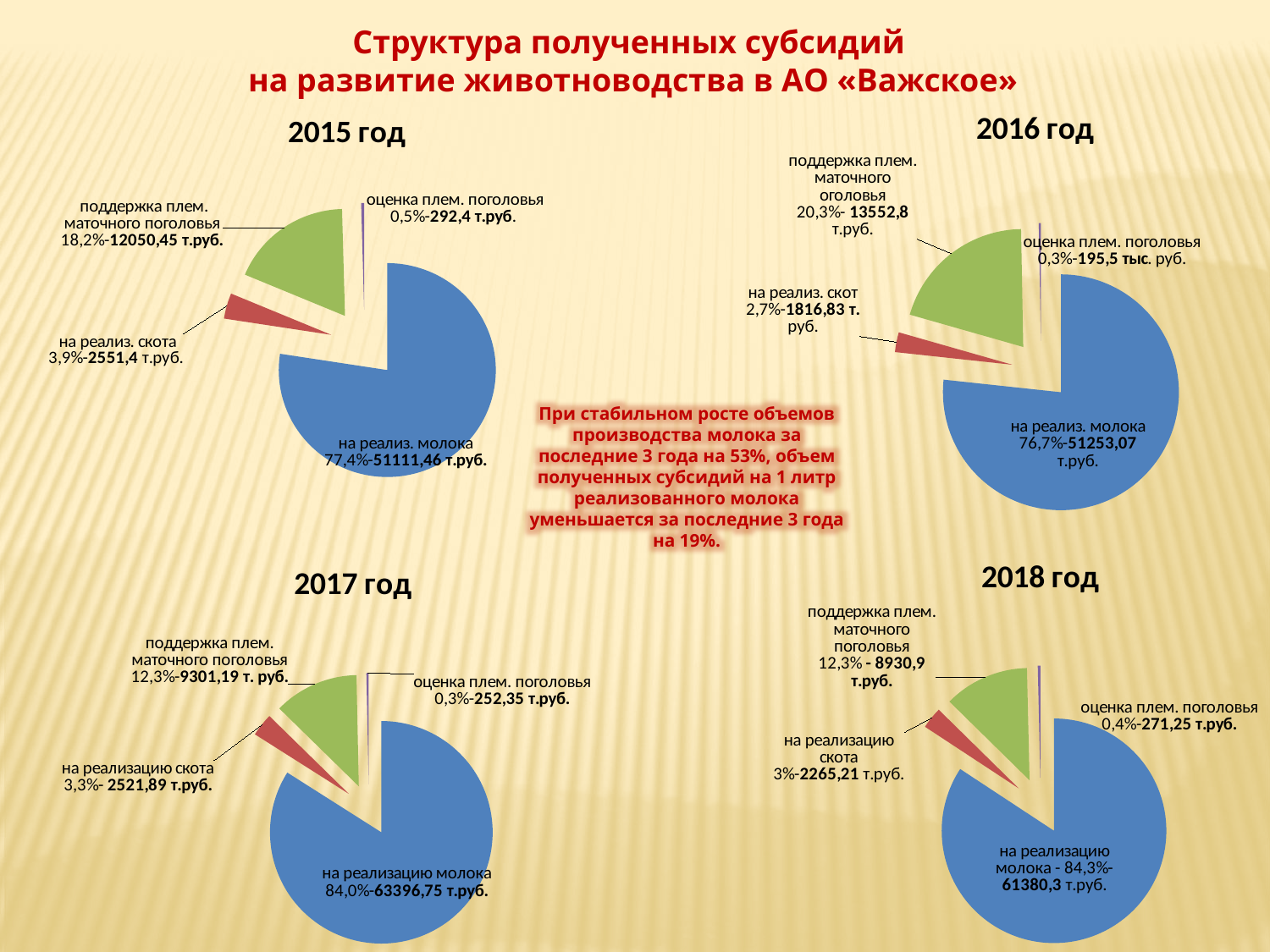
On the 2015 год pie chart, what amount is shown for поддержка плем. маточного поголовья? 12050,45 т.руб. On the 2018 год pie chart, which category has the largest share? на реализацию молока What type of chart is used for 2015 год? Pie chart On the 2017 год pie chart, what amount is shown for на реализацию молока? 63396,75 т.руб. On the 2018 год pie chart, what share of subsidies went to на реализацию молока? 84,3% How many slices does the 2016 год pie chart have? 4 On the 2016 год pie chart, what share of subsidies went to поддержка плем. маточного поголовья? 20,3% On the 2015 год pie chart, what share of subsidies went to на реализ. молока? 77,4% On the 2015 год pie chart, which is larger: the share for на реализ. скота or the share for поддержка плем. маточного поголовья? поддержка плем. маточного поголовья On the 2018 год pie chart, what amount is shown for оценка плем. поголовья? 271,25 т.руб. On the 2016 год pie chart, what amount is shown for на реализ. скот? 1816,83 т.руб. On the 2017 год pie chart, which category has the smallest share? оценка плем. поголовья